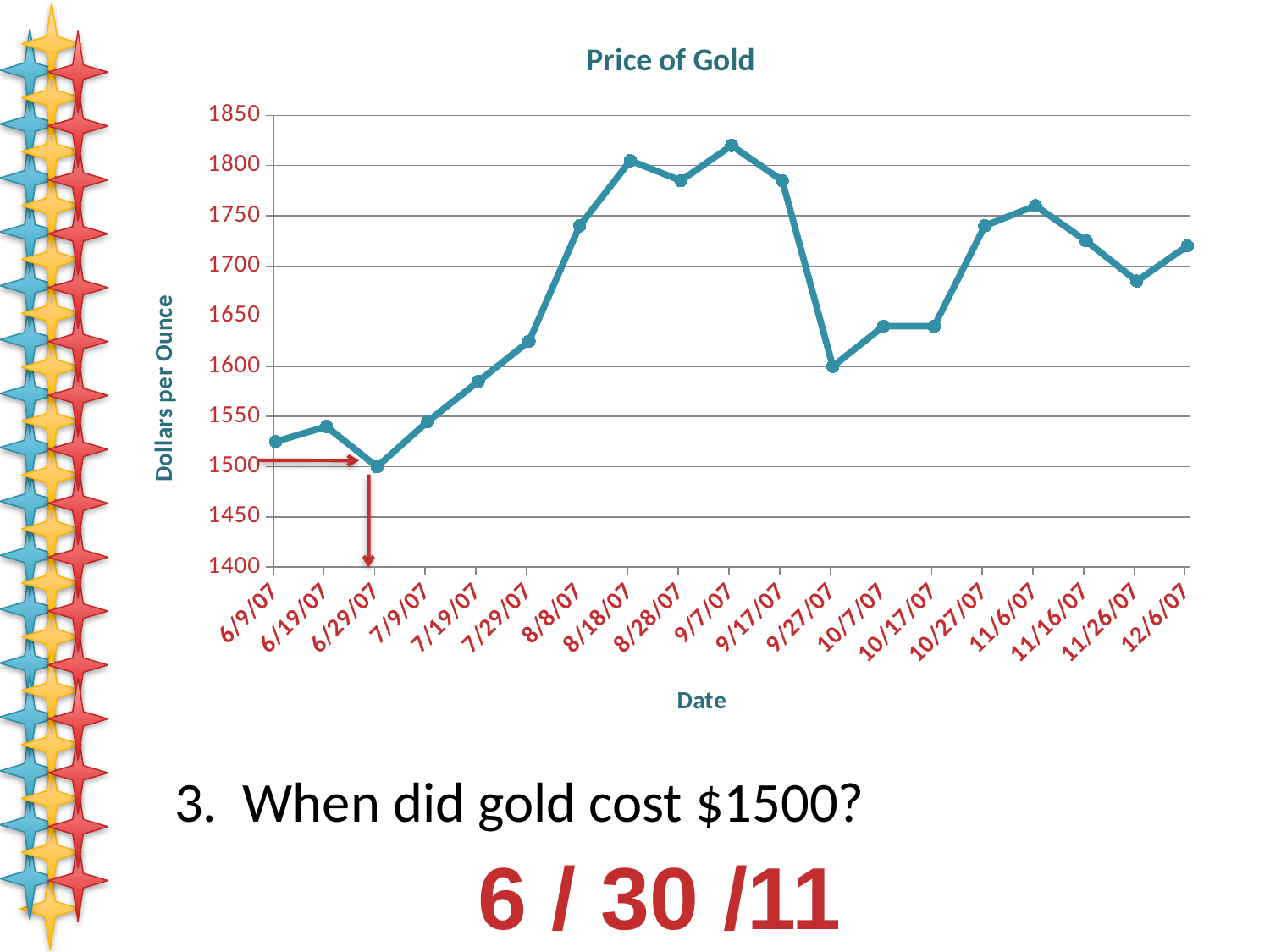
On which date was the price of gold lowest? 6/29/07 What is the title of the chart? Price of Gold What was the price of gold on 6/29/07? 1500 Which date has the higher price of gold, 8/18/07 or 8/28/07? 8/18/07 Does the price of gold rise or fall between 6/29/07 and 8/18/07? Rise Is the value for 8/8/07 greater or less than 1700? greater What is the label on the vertical axis of the chart? Dollars per Ounce What was the price of gold on 9/27/07? 1600 On which date was the price of gold highest? 9/7/07 Is the value for 11/26/07 greater or less than 1700? less What type of chart is shown on the slide? Line chart How many data points are plotted on the line? 19